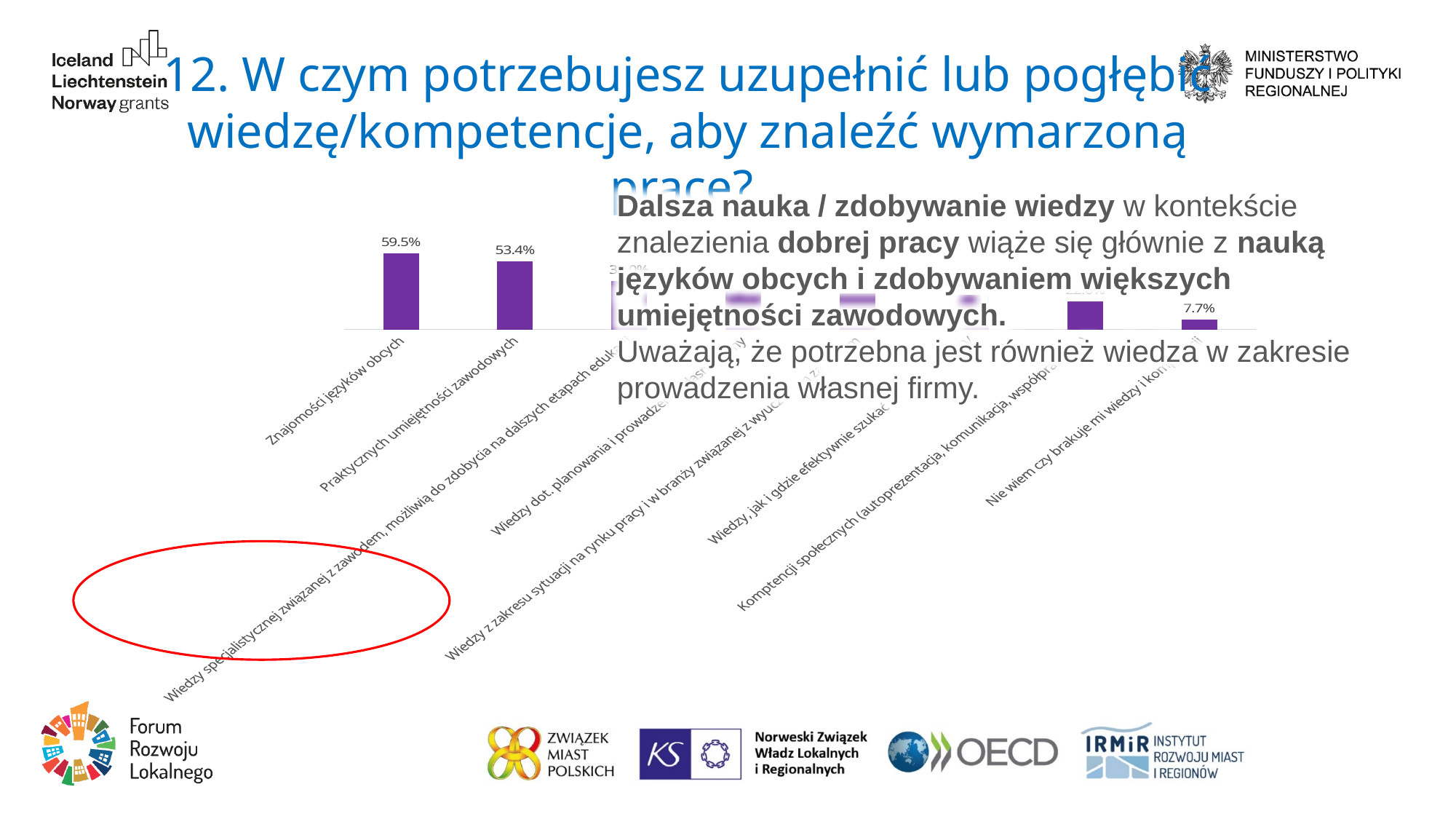
What is the value for "Praktycznych umiejętności zawodowych"? 53.4% How many categories are plotted in the chart? 8 Which is larger: the value for "Praktycznych umiejętności zawodowych" or for "Nie wiem czy brakuje mi wiedzy i kompetencji"? Praktycznych umiejętności zawodowych Which is larger: the value for "Znajomości języków obcych" or for "Praktycznych umiejętności zawodowych"? Znajomości języków obcych What is the value for "Znajomości języków obcych"? 59.5% What colour are the bars in the chart? purple What kind of chart is shown on the slide? bar chart What is the difference between the values for "Znajomości języków obcych" and "Praktycznych umiejętności zawodowych"? 6.1 percentage points What is the value for "Nie wiem czy brakuje mi wiedzy i kompetencji"? 7.7% What is the difference between the values for "Praktycznych umiejętności zawodowych" and "Nie wiem czy brakuje mi wiedzy i kompetencji"? 45.7 percentage points Which category has the highest value? Znajomości języków obcych Which category has the lowest value? Nie wiem czy brakuje mi wiedzy i kompetencji